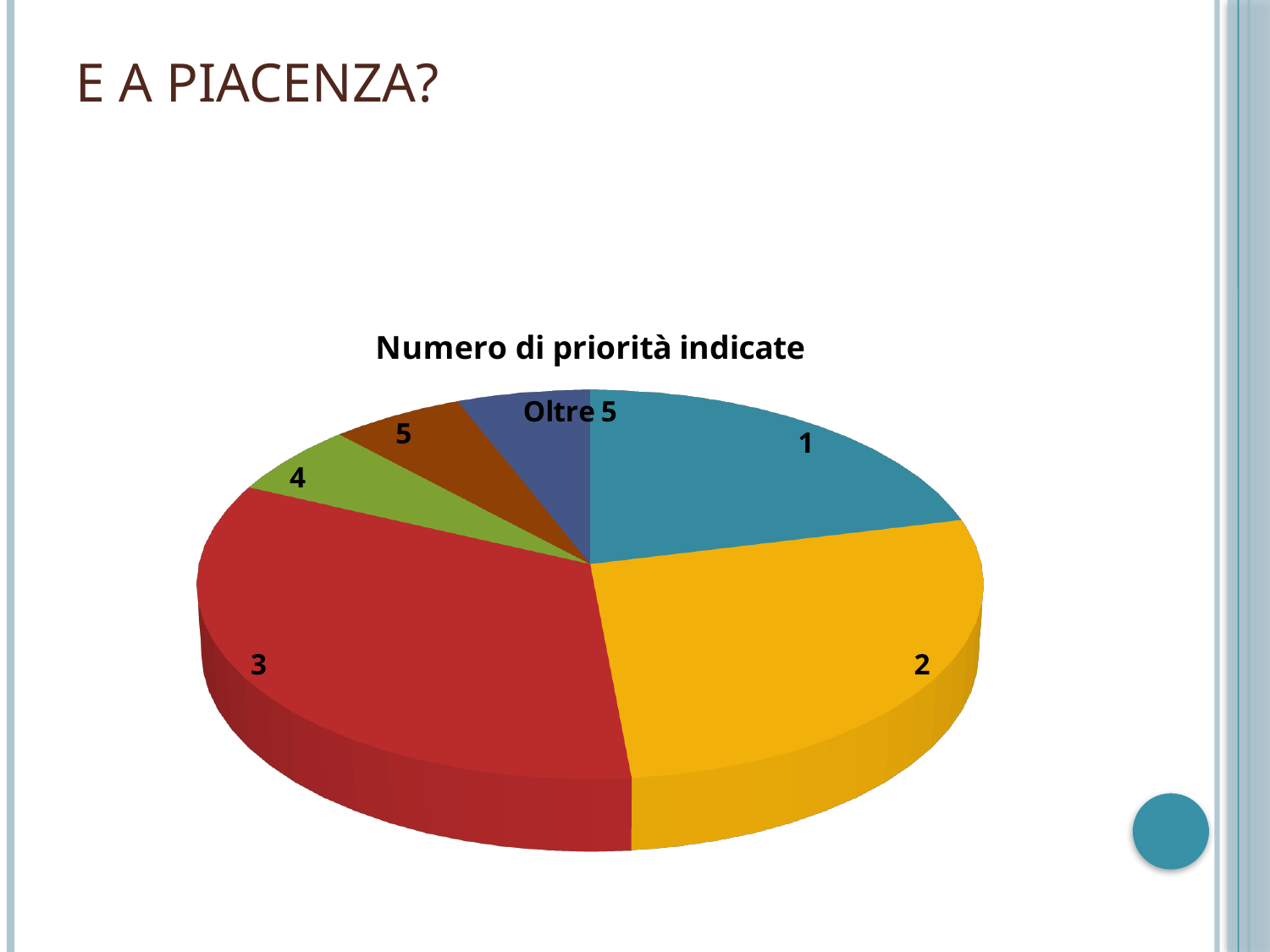
What is the title of the chart? Numero di priorità indicate What kind of chart is shown on the slide? pie chart Which slice is larger, the one for 2 or the one for Oltre 5? 2 Which category has the largest slice of the pie? 3 How many slices does the pie chart have? 6 Which slice is larger, the one for 3 or the one for Oltre 5? 3 Which slice is larger, the one for 2 or the one for 5? 2 What colour is the slice labelled 2? yellow